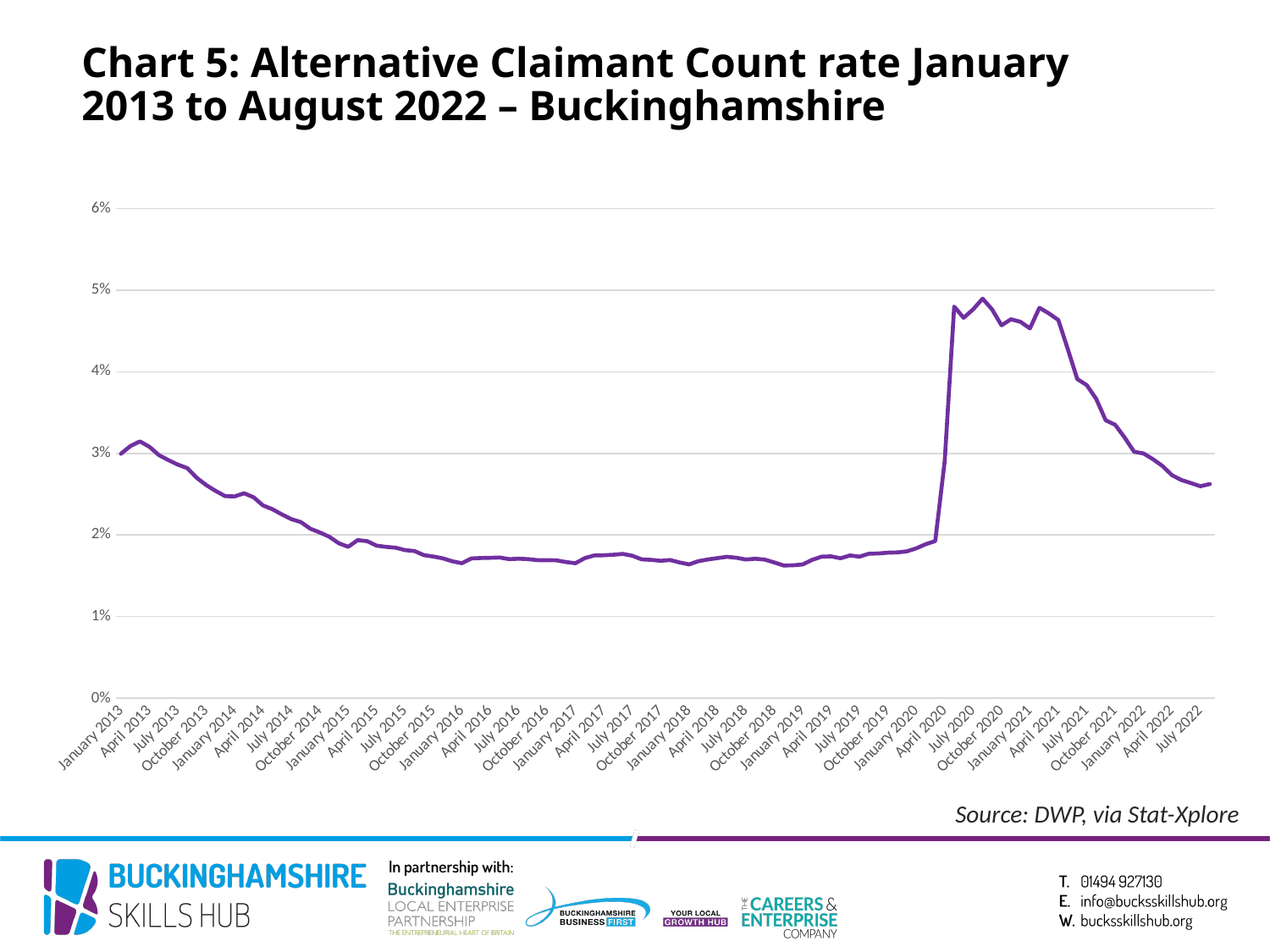
Is the Alternative Claimant Count rate for October 2021 greater or less than 3%? greater What is the highest value shown on the vertical axis of the chart? 6% Is the Alternative Claimant Count rate for July 2022 greater or less than 3%? less Does the Alternative Claimant Count rate rise or fall between April 2021 and July 2022? fall Is the Alternative Claimant Count rate for July 2020 greater or less than 4%? greater What kind of chart is shown on the slide? line chart Does the Alternative Claimant Count rate rise or fall between January 2013 and January 2016? fall What source is cited for the chart data? DWP, via Stat-Xplore In which year does the Alternative Claimant Count rate reach its highest point? 2020